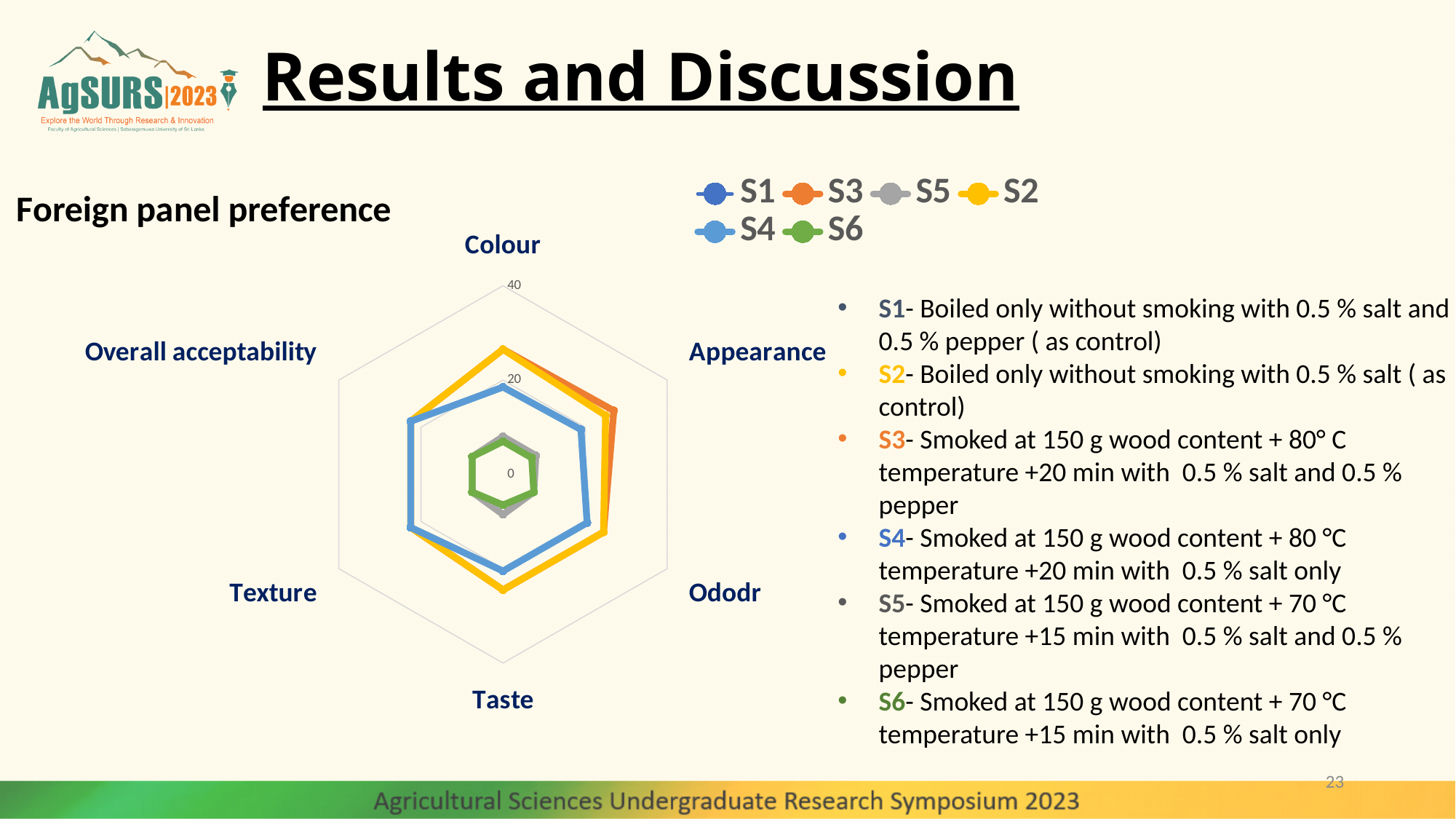
How many categories (axes) does the radar chart have? 6 Is the value for S2 on Colour greater or less than 20? greater What kind of chart is shown on the slide? radar chart Is the value for S2 on Taste greater or less than 20? greater What is the title of the chart? Foreign panel preference How many series does the chart legend list? 6 Which category is placed at the top of the radar chart? Colour Which is larger for Taste, S4 or S6? S4 Is the value for S5 on Taste greater or less than 20? less Which is larger for Texture, S2 or S6? S2